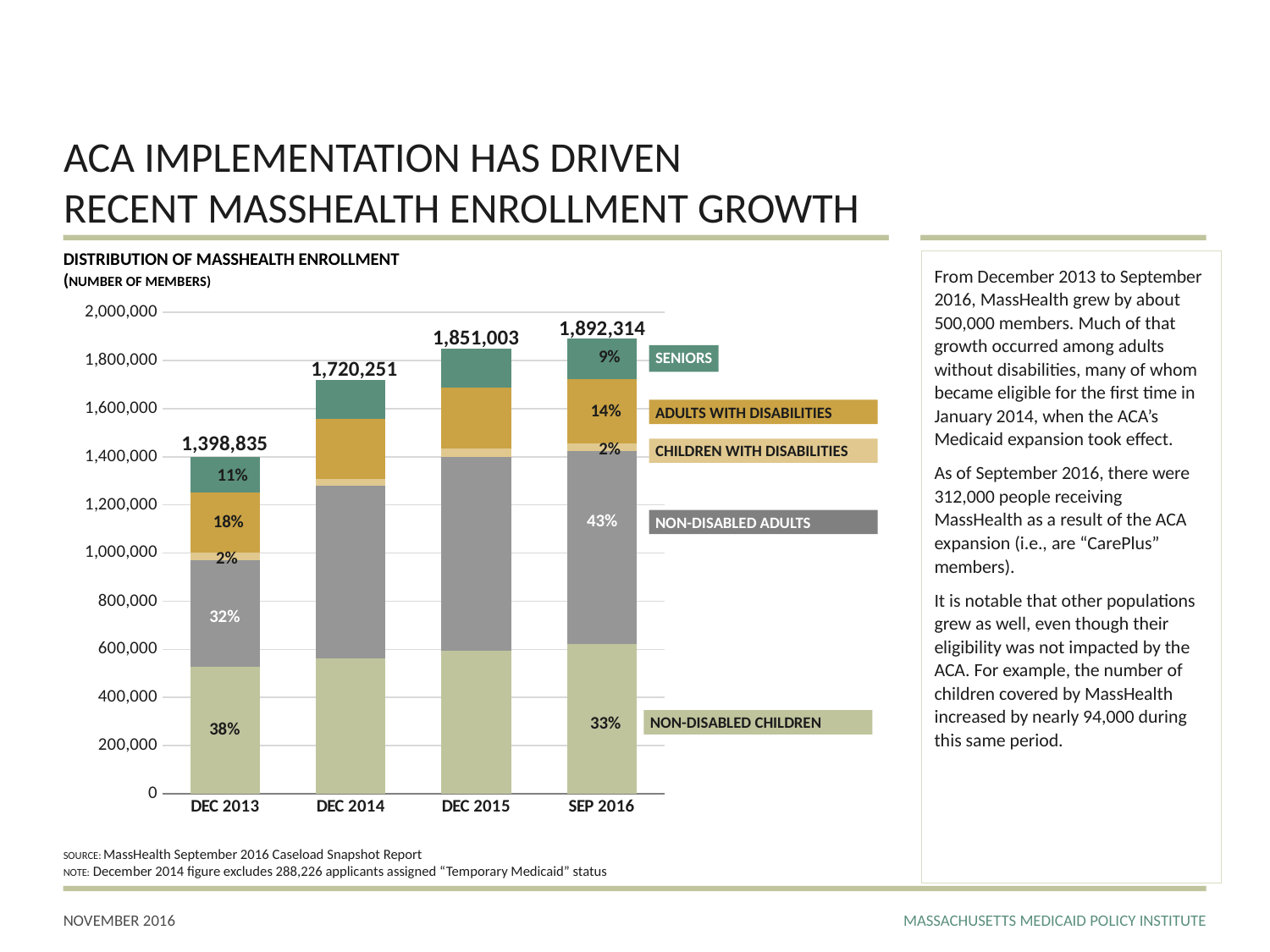
What percentage of enrollment in SEP 2016 is labeled for Non-Disabled Adults? 43% What is the total MassHealth enrollment shown for SEP 2016? 1,892,314 Does total enrollment rise or fall from DEC 2013 to SEP 2016? rise Which has the larger total enrollment, DEC 2014 or DEC 2015? DEC 2015 Which period has the highest total enrollment? SEP 2016 What percentage of enrollment in DEC 2013 is labeled for Non-Disabled Children? 38% What percentage of enrollment in DEC 2013 is labeled for Seniors? 11% Which period has the lowest total enrollment? DEC 2013 How many time periods are shown on the x axis? 4 What is the difference between the total enrollment in SEP 2016 and in DEC 2013? 493,479 What is the total MassHealth enrollment shown for DEC 2013? 1,398,835 How many enrollment categories (series) are labeled in the chart? 5